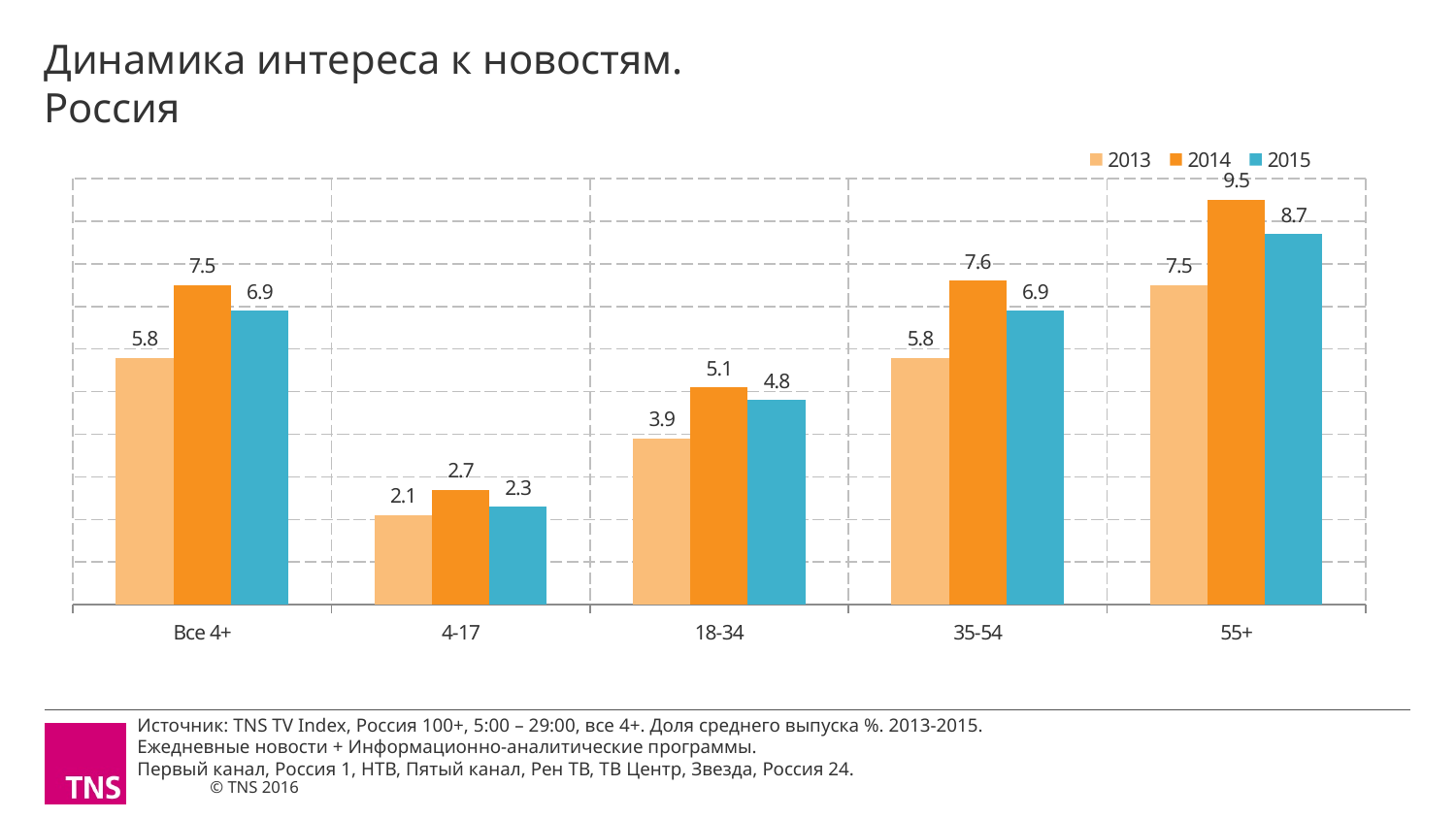
Which age group has the highest value in 2015? 55+ Which year does the orange series in the legend represent? 2014 What is the value for 55+ in 2014? 9.5 Which age group has the lowest value in 2014? 4-17 What is the difference between the 2014 and 2013 values for 55+? 2.0 How many age groups are shown on the x axis? 5 Which is larger for 35-54: the 2013 value or the 2015 value? 2015 What is the value for 18-34 in 2015? 4.8 What kind of chart is shown on the slide? bar chart What is the difference between the 2014 and 2015 values for 18-34? 0.3 How many series does the legend list? 3 What is the value for 4-17 in 2013? 2.1